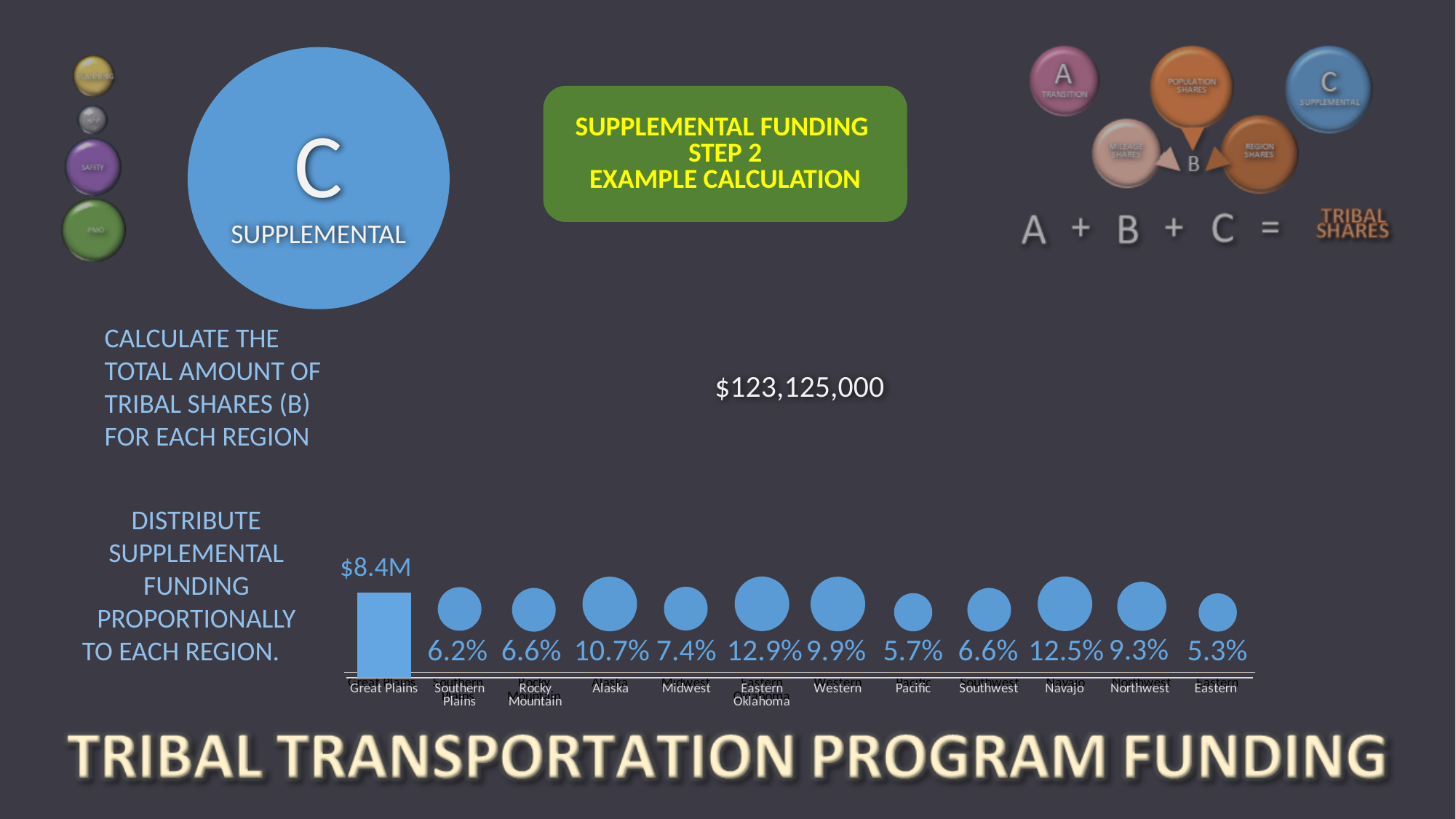
What percentage is shown for Eastern Oklahoma? 12.9% Which two regions share the same percentage of 6.6%? Rocky Mountain and Southwest What value is shown for Great Plains in the chart? $8.4M Which region has the highest percentage shown in the chart? Eastern Oklahoma What percentage is shown for Pacific? 5.7% What is the difference between the percentages for Eastern Oklahoma and Navajo? 0.4% How many regions are shown along the x axis of the chart? 12 What percentage is shown for Alaska? 10.7% Which has a larger percentage, Western or Northwest? Western What is the difference between the percentages for Midwest and Southern Plains? 1.2% What percentage is shown for Navajo? 12.5% Which region has the lowest percentage shown in the chart? Eastern